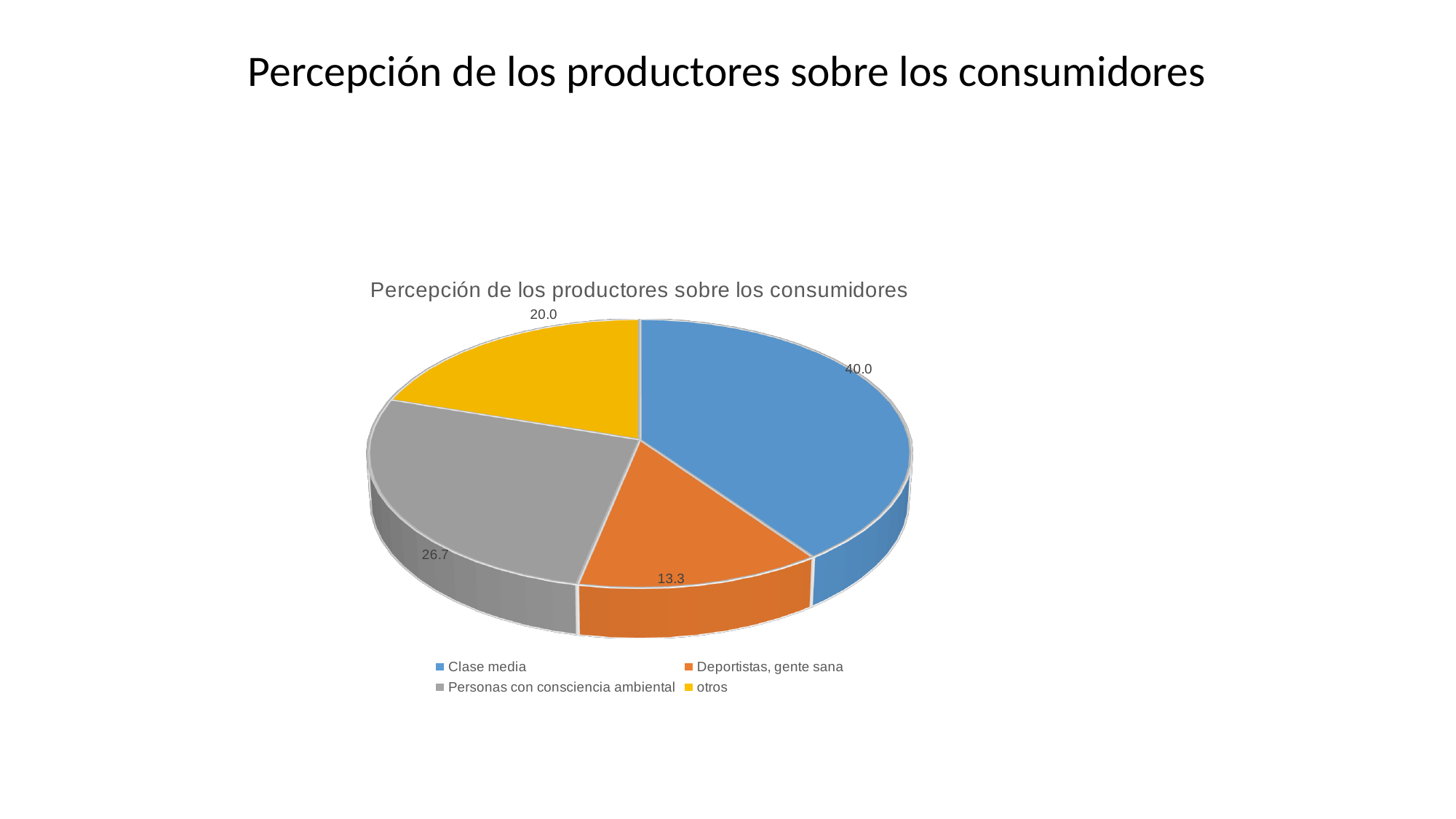
Which colour represents otros in the legend? Yellow Which category has the smallest slice? Deportistas, gente sana What is the value for Clase media? 40.0 How many categories does the pie chart show? 4 Which category has the largest slice? Clase media Which is larger, Personas con consciencia ambiental or otros? Personas con consciencia ambiental What is the title of the chart? Percepción de los productores sobre los consumidores What is the value for Personas con consciencia ambiental? 26.7 What kind of chart is shown on the slide? Pie chart What is the value for Deportistas, gente sana? 13.3 What is the difference between the values for Clase media and otros? 20.0 What is the value for otros? 20.0